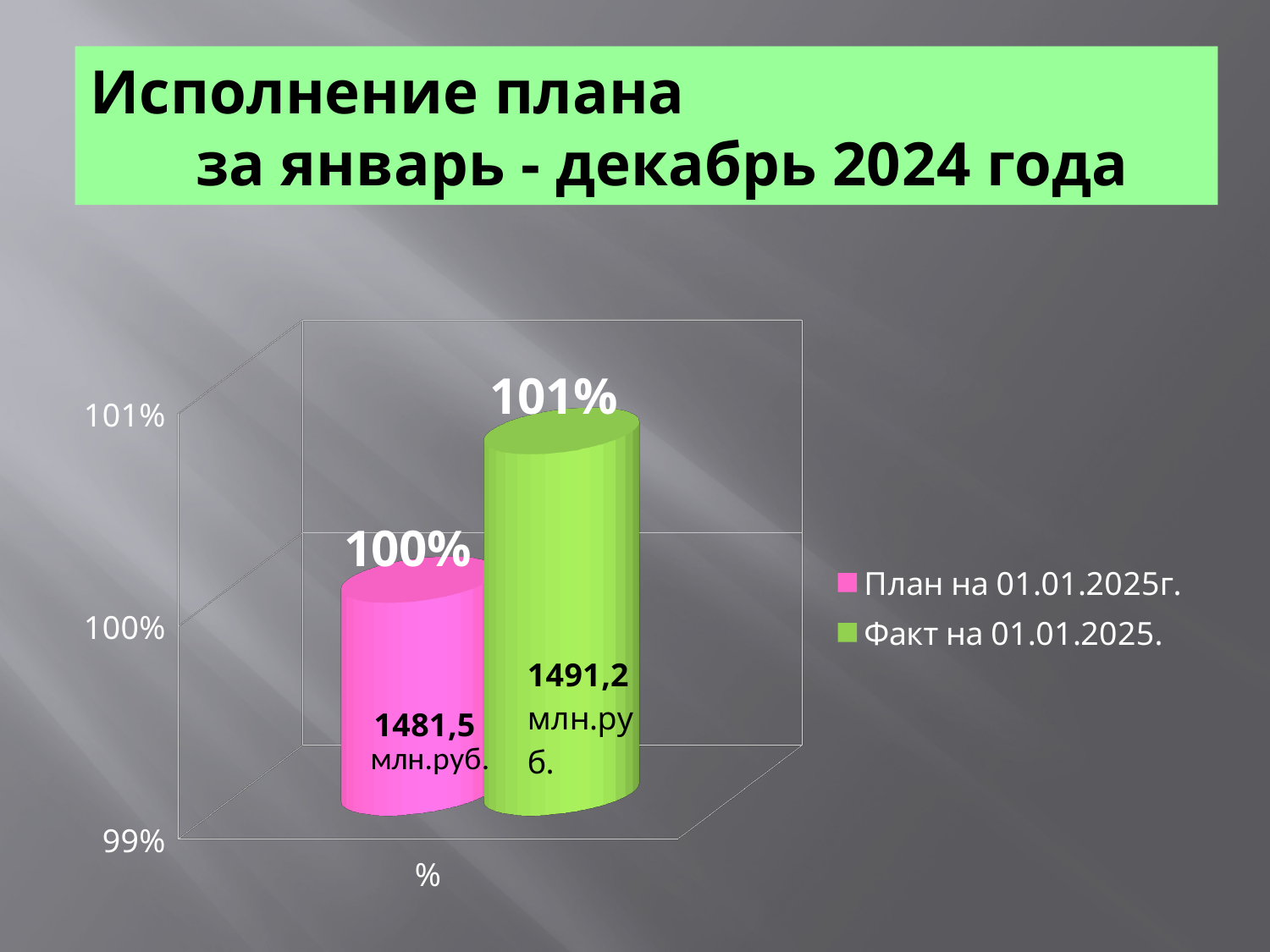
What is the data label shown on the bar for План на 01.01.2025г.? 100% How many series does the legend list? 2 What is the title of the slide containing the chart? Исполнение плана за январь - декабрь 2024 года Which series has the highest bar? Факт на 01.01.2025. What is the data label shown on the bar for Факт на 01.01.2025.? 101% Which series has the lowest bar? План на 01.01.2025г. What amount in млн.руб. is written on the pink План bar? 1481,5 млн.руб. What kind of chart is shown on the slide? bar chart What amount in млн.руб. is written on the green Факт bar? 1491,2 млн.руб. Which series has the higher bar, План на 01.01.2025г. or Факт на 01.01.2025.? Факт на 01.01.2025. What colour is the bar for Факт на 01.01.2025.? green What is the difference in percentage points between the Факт and План bars according to their data labels? 1%